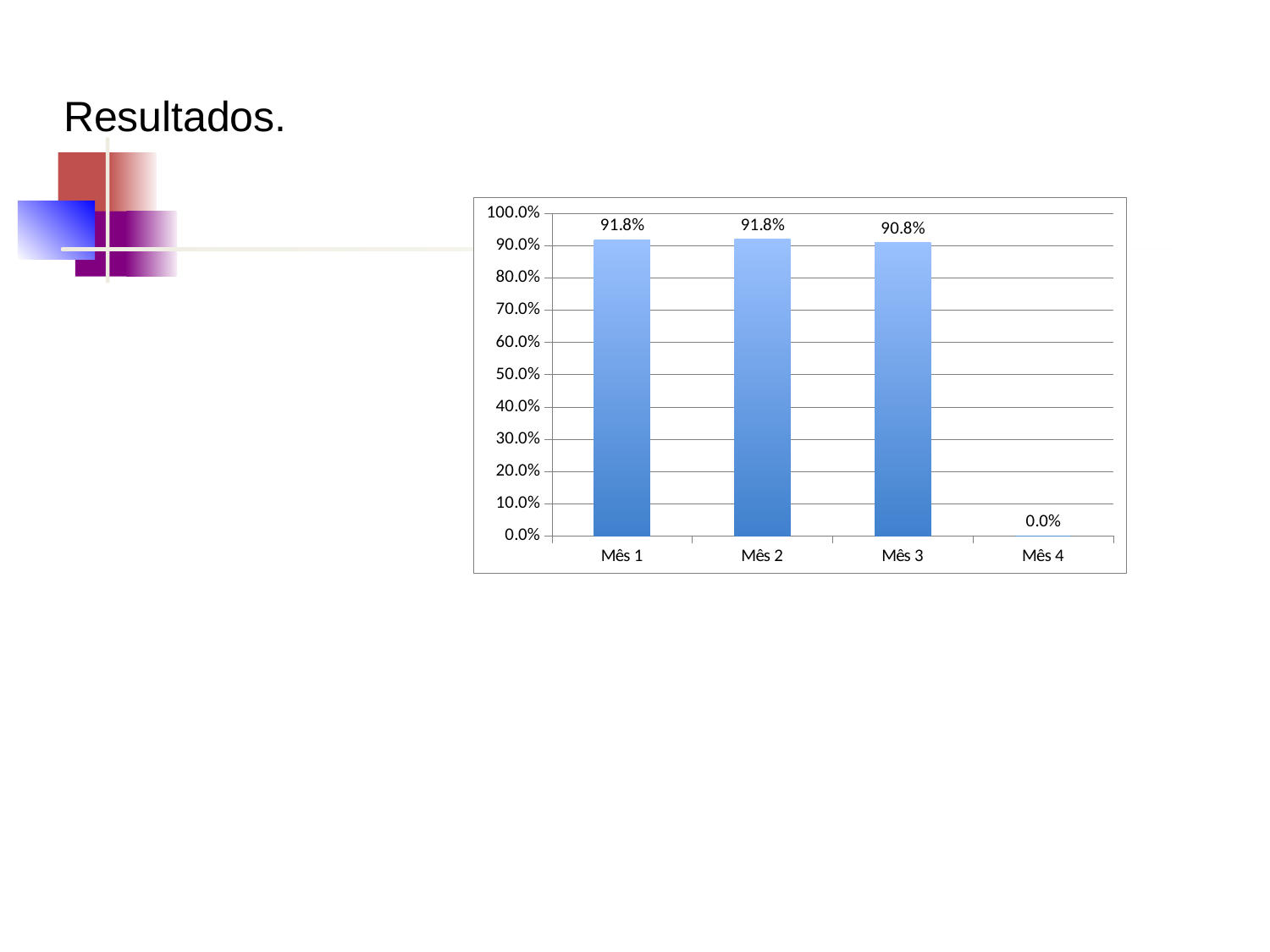
Which category has the lowest value? Mês 4 What is the title of the slide? Resultados. Do the values rise or fall from Mês 1 to Mês 4? fall What is the value for Mês 1? 91.8% What is the highest value shown on the y axis? 100.0% What is the value for Mês 4? 0.0% Is the value for Mês 2 greater or less than 90.0%? greater How many categories are shown on the x axis? 4 What kind of chart is shown on the slide? bar chart What is the difference between the values for Mês 2 and Mês 3? 1.0% What is the value for Mês 3? 90.8% Which is larger, the value for Mês 1 or the value for Mês 3? Mês 1